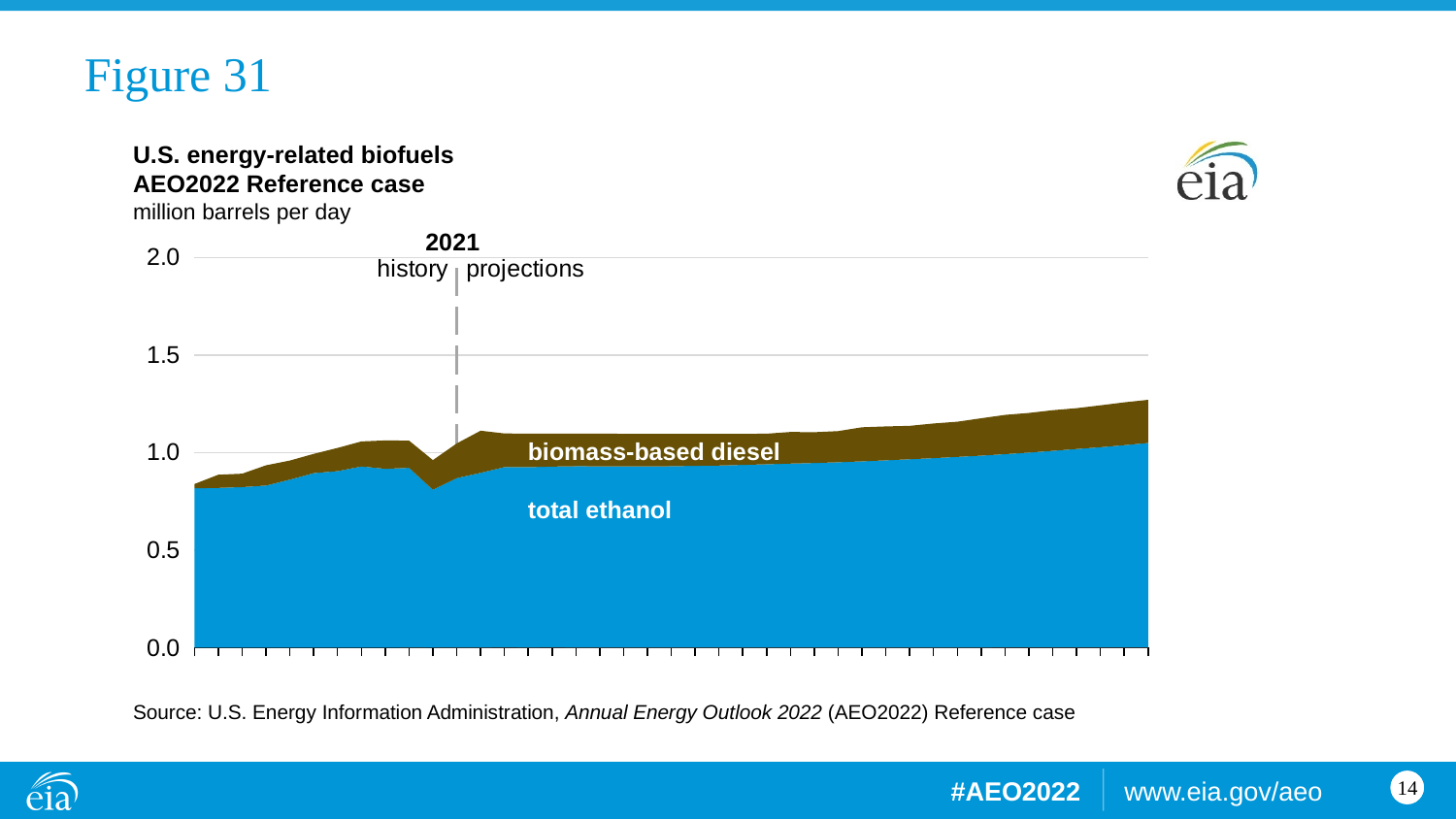
What is the highest value shown on the y axis? 2.0 How many series are plotted in the chart? 2 Which year separates history from projections in the chart? 2021 What unit is the y axis measured in? million barrels per day What kind of chart is shown on the slide? Stacked area chart Is the value for total ethanol at the left end of the chart greater or less than 0.5? greater Is the combined total of biofuels at the right end of the chart greater or less than 1.5? less Is the combined total of biofuels at the right end of the chart greater or less than 1.0? greater What is the title of the chart? U.S. energy-related biofuels AEO2022 Reference case Does the combined total of biofuels rise or fall over the projection period after 2021? rise Which series is larger throughout the chart, total ethanol or biomass-based diesel? total ethanol